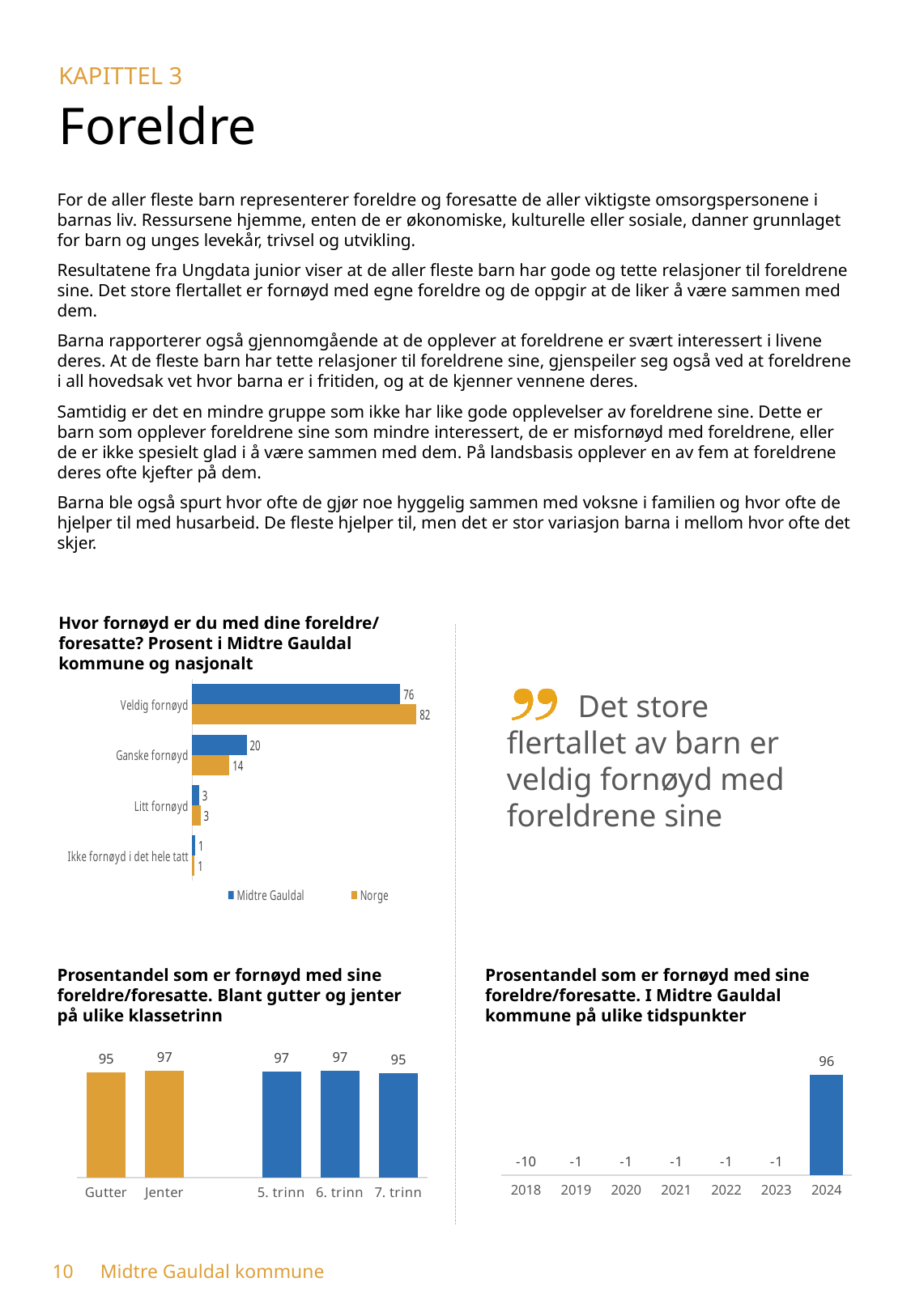
In the chart 'Prosentandel som er fornøyd med sine foreldre/foresatte. I Midtre Gauldal kommune på ulike tidspunkter', what is the value for 2024? 96 In the chart 'Prosentandel som er fornøyd med sine foreldre/foresatte. Blant gutter og jenter på ulike klassetrinn', what is the value for 7. trinn? 95 In the chart 'Hvor fornøyd er du med dine foreldre/foresatte?', which category has the lowest value for Midtre Gauldal? Ikke fornøyd i det hele tatt In the chart 'Hvor fornøyd er du med dine foreldre/foresatte?', what is the difference between the Norge and Midtre Gauldal values for 'Veldig fornøyd'? 6 In the chart 'Prosentandel som er fornøyd med sine foreldre/foresatte. Blant gutter og jenter på ulike klassetrinn', what is the value for Jenter? 97 In the chart 'Hvor fornøyd er du med dine foreldre/foresatte?', which is larger for 'Ganske fornøyd': Midtre Gauldal or Norge? Midtre Gauldal In the chart 'Hvor fornøyd er du med dine foreldre/foresatte?', how many series does the legend list? 2 In the chart 'Hvor fornøyd er du med dine foreldre/foresatte?', how many categories are shown? 4 In the chart 'Prosentandel som er fornøyd med sine foreldre/foresatte. Blant gutter og jenter på ulike klassetrinn', what is the difference between Jenter and Gutter? 2 What kind of chart is 'Hvor fornøyd er du med dine foreldre/foresatte?'? Bar chart In the chart 'Hvor fornøyd er du med dine foreldre/foresatte?', what is the value for Norge in the 'Ganske fornøyd' category? 14 In the chart 'Hvor fornøyd er du med dine foreldre/foresatte?', what is the value for Midtre Gauldal in the 'Veldig fornøyd' category? 76